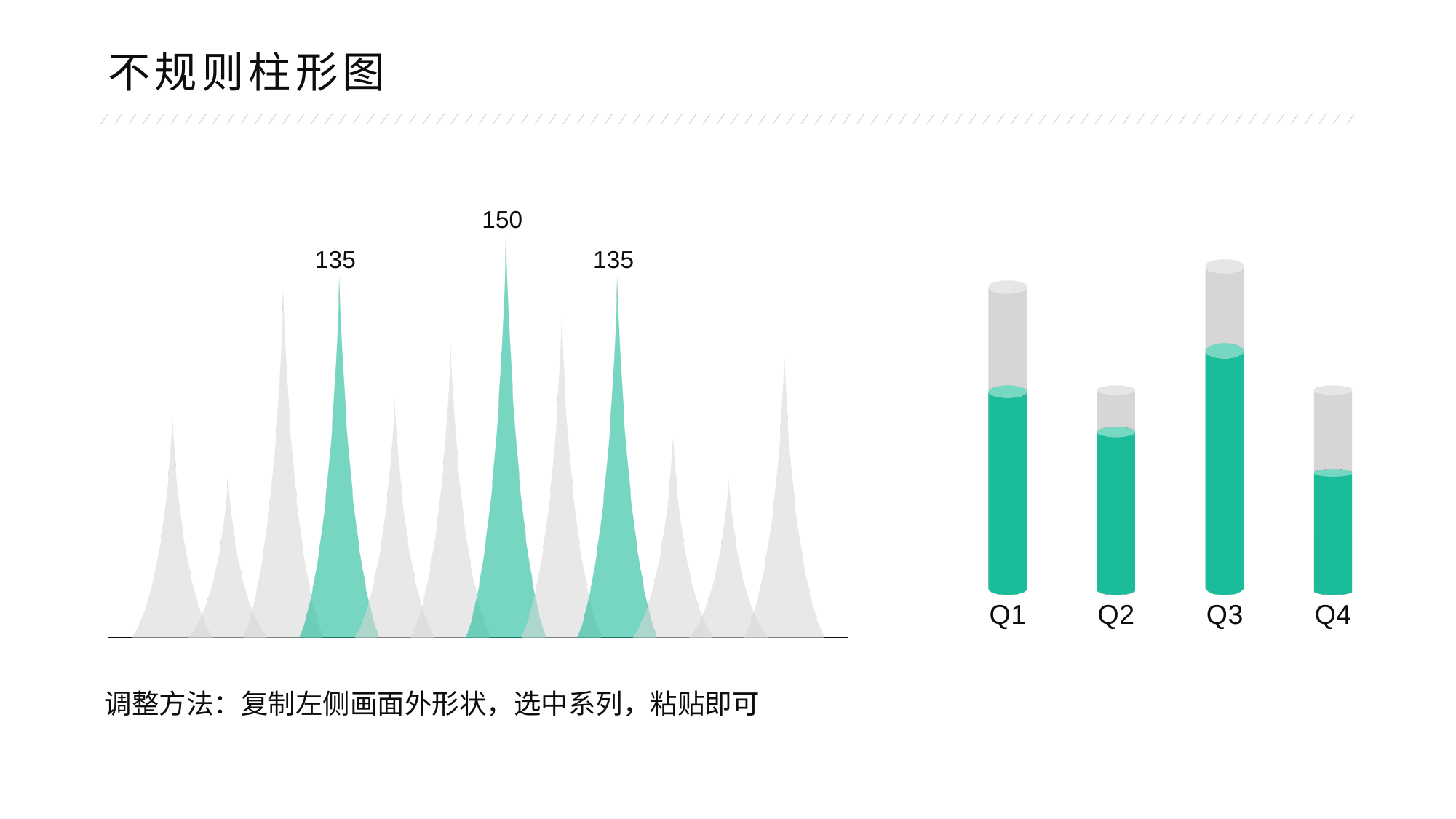
On the left chart, how many data labels are printed? 3 On the right chart, which has the taller green bar, Q2 or Q4? Q2 On the right chart, which category has the shortest green bar? Q4 What is the title of the slide? 不规则柱形图 On the right chart, which category has the tallest green bar? Q3 On the right chart, which has the taller green bar, Q1 or Q2? Q1 What kind of chart is shown on the right side of the slide? Bar chart On the left chart, how many spikes are highlighted in green? 3 On the left chart, what is the highest value printed as a data label? 150 On the left chart, what is the difference between the highest labeled value (150) and the lowest labeled value (135)? 15 On the right chart, how many categories are shown on the x axis? 4 On the left chart, what is the lowest value printed as a data label? 135